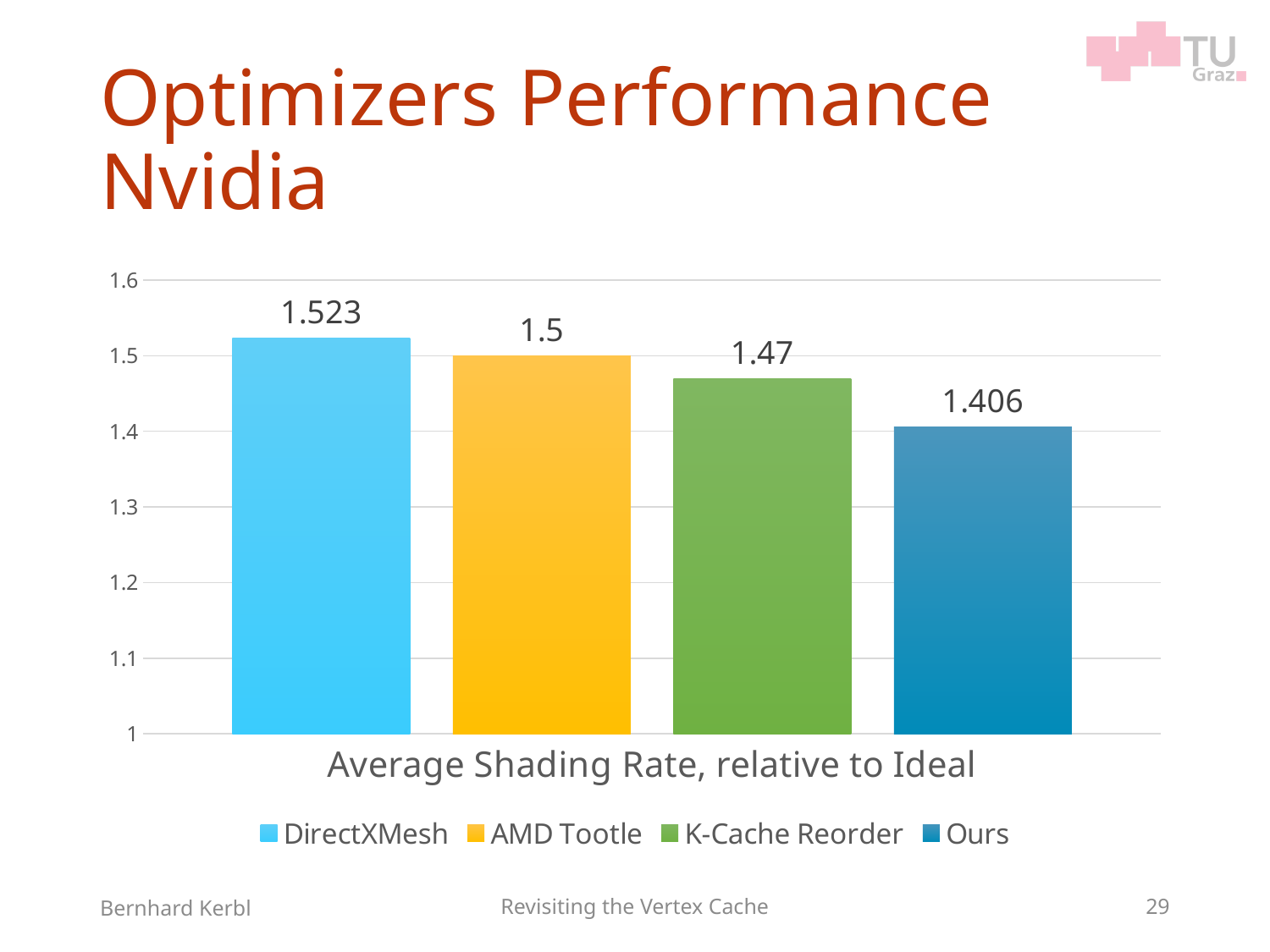
What is the value for K-Cache Reorder? 1.47 Which series has the highest value? DirectXMesh What kind of chart is shown on the slide? bar chart Which series has the lowest value? Ours What is the value for DirectXMesh? 1.523 What is the category label shown below the bars? Average Shading Rate, relative to Ideal What is the difference between the values for DirectXMesh and Ours? 0.117 How many series does the legend list? 4 Which is larger, the value for AMD Tootle or the value for K-Cache Reorder? AMD Tootle Is the value for Ours greater or less than 1.5? less What is the value for Ours? 1.406 What is the value for AMD Tootle? 1.5